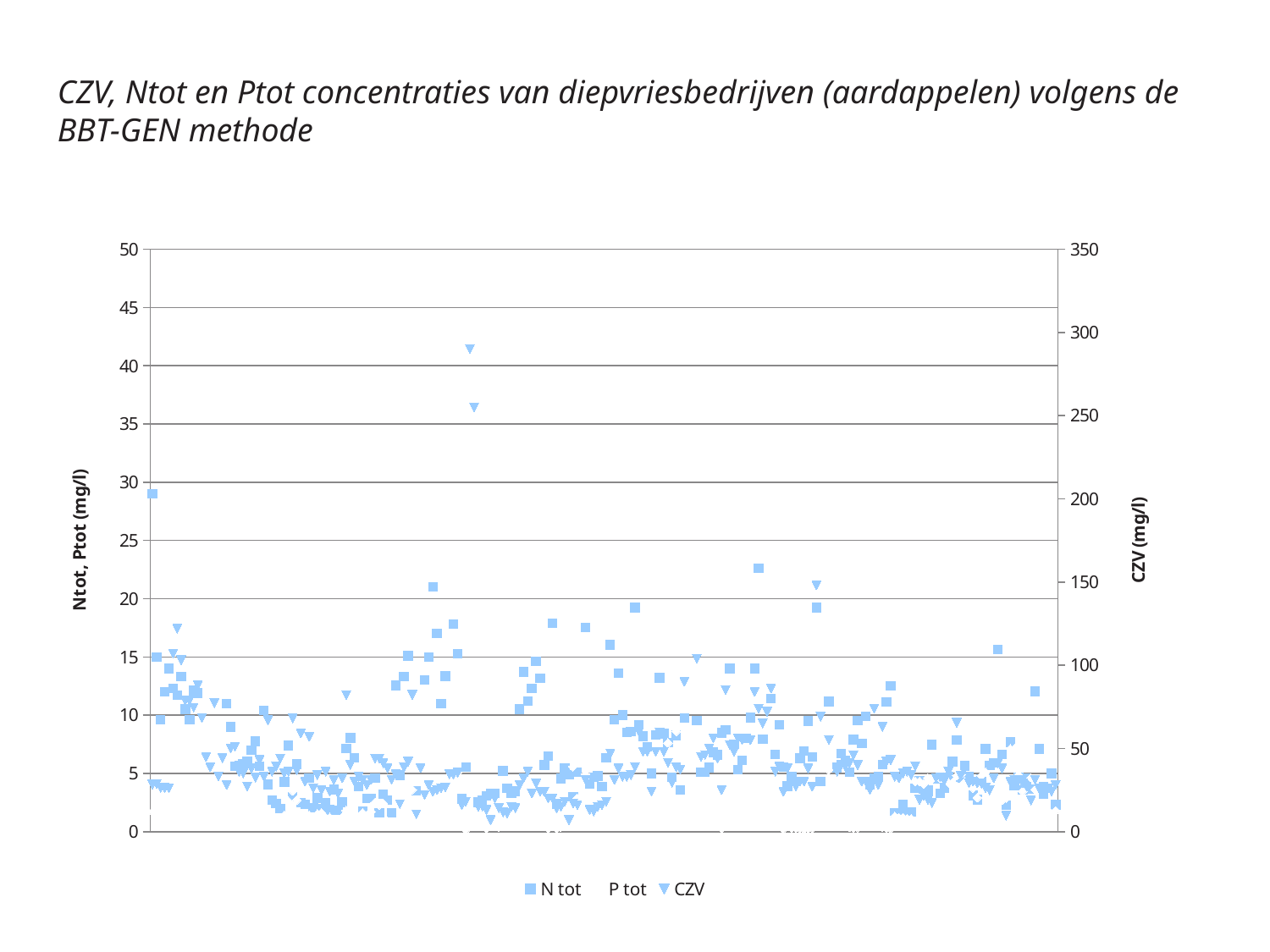
What is the label of the right-hand vertical axis? CZV (mg/l) What is the maximum value shown on the right vertical axis (CZV)? 350 Is the highest CZV value plotted greater or less than 250 on the right axis? greater Which series is plotted with triangle markers according to the legend? CZV What is the maximum value shown on the left vertical axis? 50 How many series does the legend list? 3 What is the title of the chart? CZV, Ntot en Ptot concentraties van diepvriesbedrijven (aardappelen) volgens de BBT-GEN methode Is the highest N tot value plotted greater or less than 25 on the left axis? greater What kind of chart is shown on the slide? scatter chart